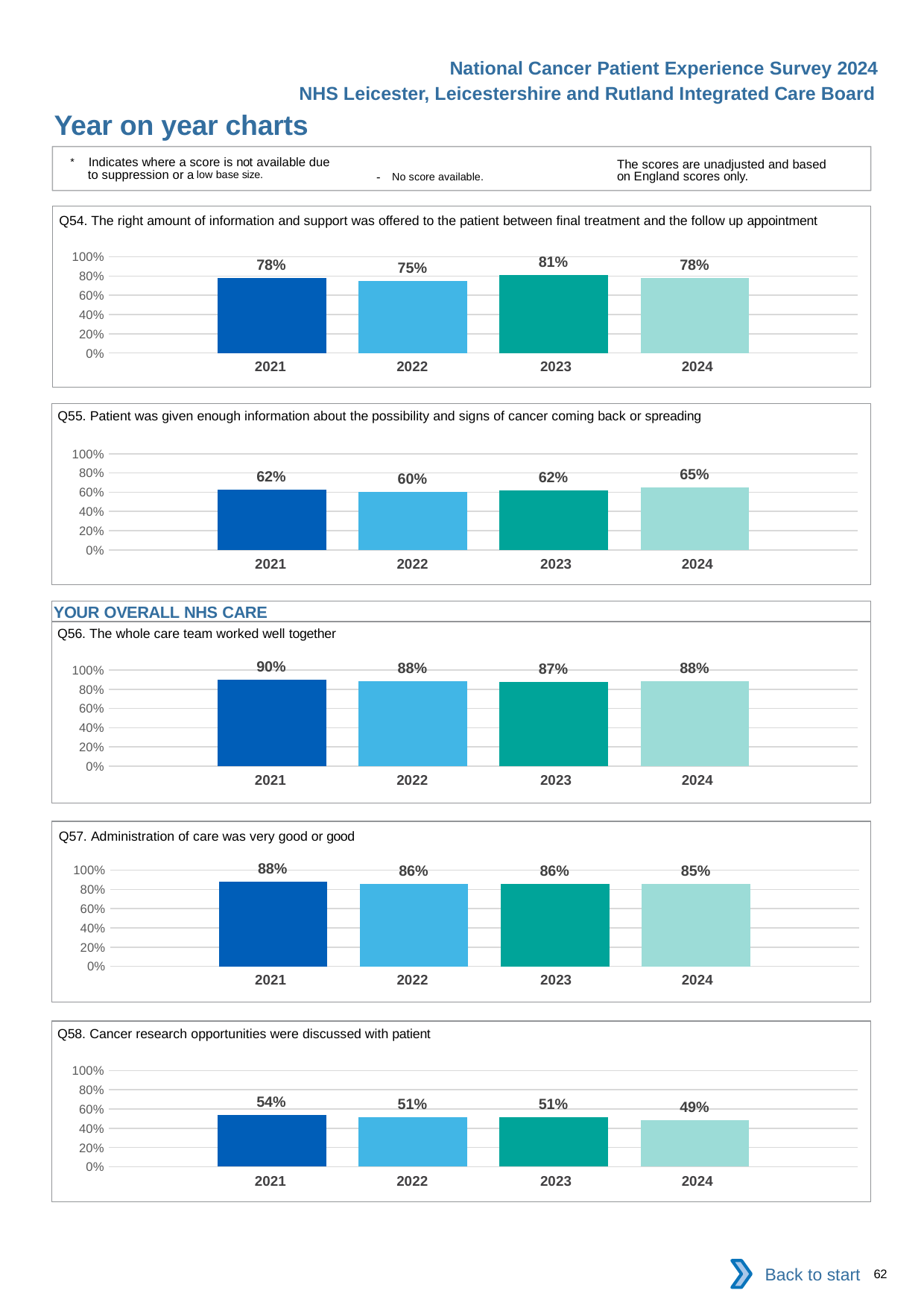
What kind of chart is the Q55 chart? bar chart In the Q55 chart, which year has the highest value? 2024 How many charts are shown on the slide? 5 How many years are shown on the x axis of the Q54 chart? 4 In the Q54 chart, what is the difference between the 2023 and 2022 values? 6% In the Q54 chart, what is the value for 2023? 81% In the Q55 chart, what is the value for 2022? 60% In the Q57 chart, which is larger, the value for 2021 or the value for 2024? 2021 In the Q58 chart, which year has the lowest value? 2024 In the Q57 chart, do the values rise or fall from 2021 to 2024? fall In the Q56 chart, what is the difference between the 2021 and 2023 values? 3% In the Q58 chart, what is the value for 2021? 54%